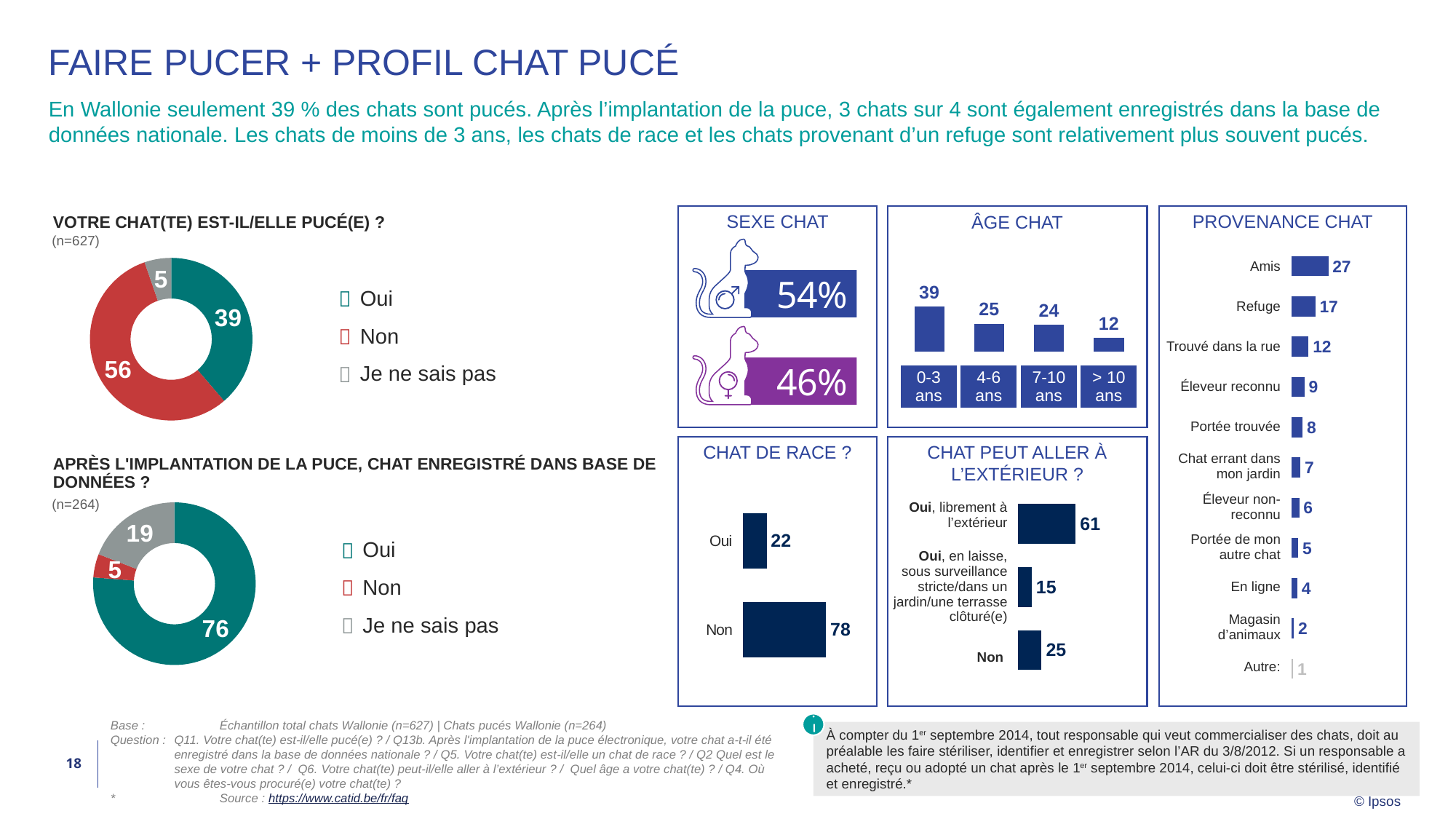
In the 'VOTRE CHAT(TE) EST-IL/ELLE PUCÉ(E) ?' donut chart, what is the value for 'Oui'? 39 In the 'PROVENANCE CHAT' bar chart, what is the value for 'Refuge'? 17 In the 'SEXE CHAT' panel, what is the percentage shown for male cats? 54% In the 'VOTRE CHAT(TE) EST-IL/ELLE PUCÉ(E) ?' donut chart, what is the value for 'Non'? 56 In the 'ÂGE CHAT' bar chart, which age group has the highest value? 0-3 ans In the 'APRÈS L'IMPLANTATION DE LA PUCE, CHAT ENREGISTRÉ DANS BASE DE DONNÉES ?' donut chart, what is the difference between 'Oui' and 'Je ne sais pas'? 57 In the 'PROVENANCE CHAT' bar chart, which category has the highest value? Amis In the 'ÂGE CHAT' bar chart, do the values rise or fall from '0-3 ans' to '> 10 ans'? fall In the 'CHAT PEUT ALLER À L'EXTÉRIEUR ?' bar chart, which is larger: 'Non' or 'Oui, en laisse, sous surveillance stricte/dans un jardin/une terrasse clôturé(e)'? Non In the 'ÂGE CHAT' bar chart, how many age categories are shown? 4 In the 'CHAT DE RACE ?' bar chart, what is the difference between 'Non' and 'Oui'? 56 In the 'APRÈS L'IMPLANTATION DE LA PUCE, CHAT ENREGISTRÉ DANS BASE DE DONNÉES ?' donut chart, which category has the lowest value? Non